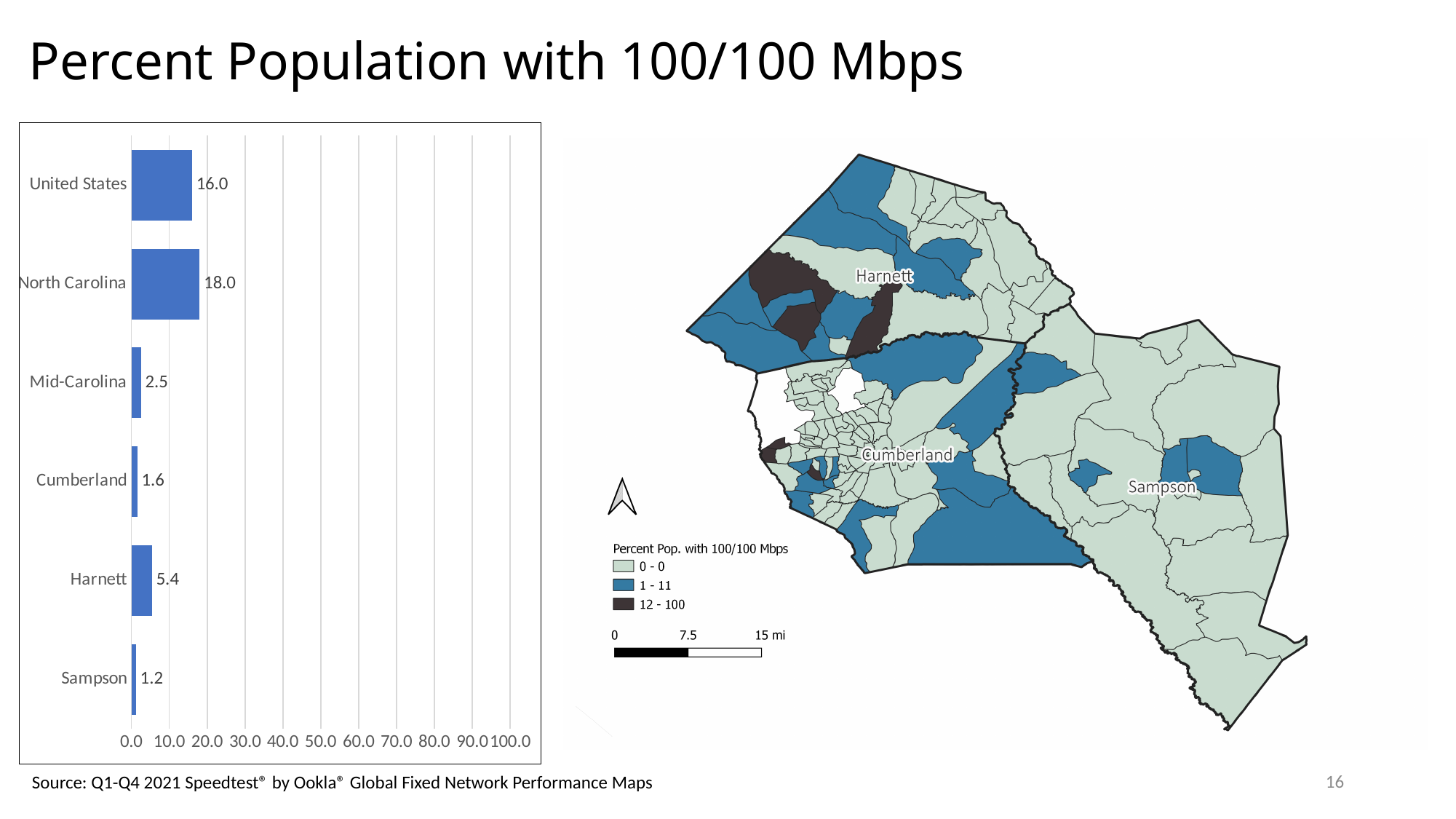
Which category has the highest value in the bar chart? North Carolina What kind of chart is shown on the left of the slide? bar chart What is the value for Sampson in the bar chart? 1.2 Which category has the lowest value in the bar chart? Sampson Which is larger in the bar chart, Harnett or Mid-Carolina? Harnett What is the value for North Carolina in the bar chart? 18.0 What is the highest value shown on the x axis of the bar chart? 100.0 Is the value for the United States in the bar chart greater or less than 20.0? less How many categories are shown in the bar chart? 6 What is the value for Harnett in the bar chart? 5.4 What is the difference between the values for North Carolina and the United States in the bar chart? 2.0 What is the value for Cumberland in the bar chart? 1.6